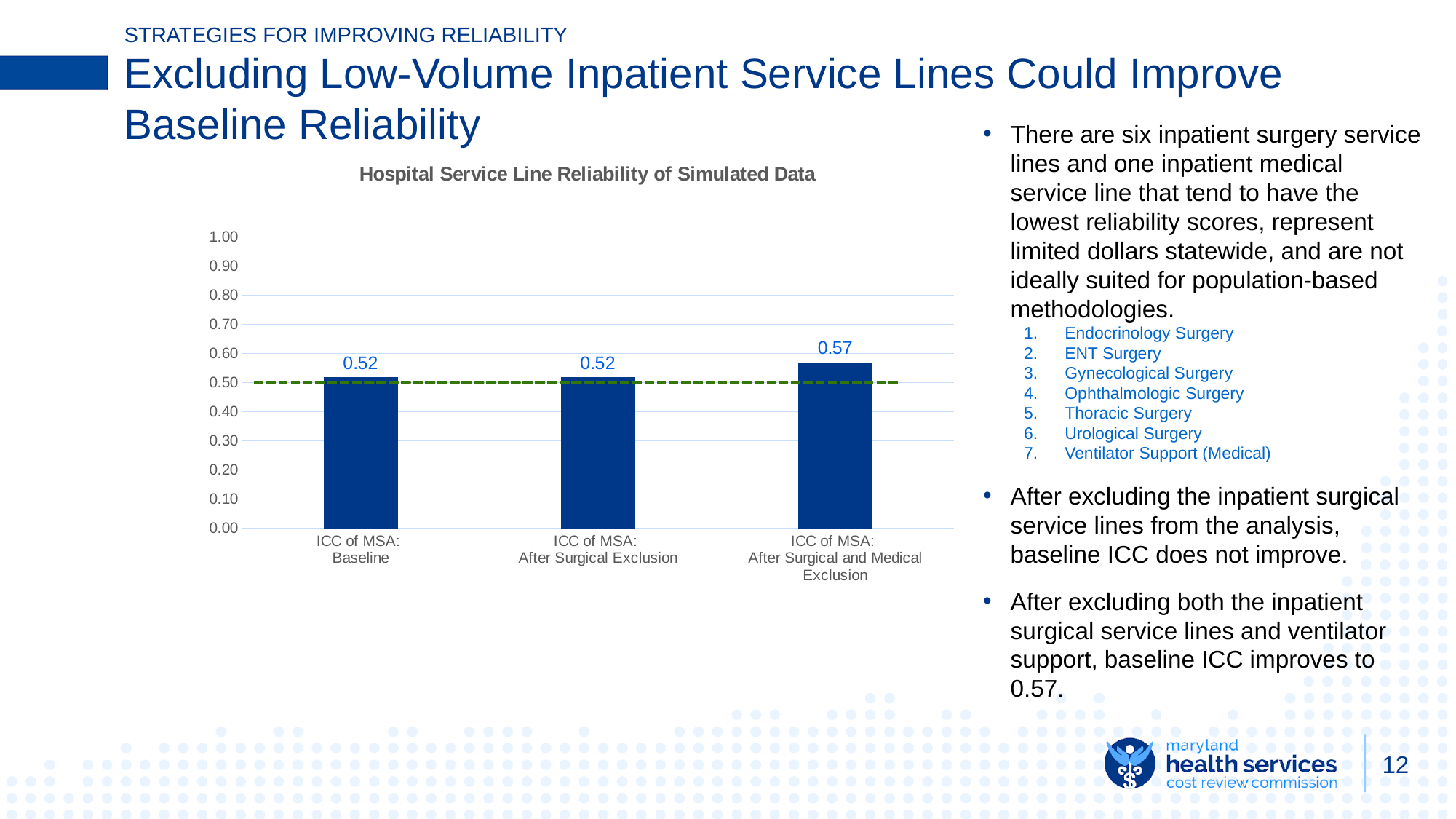
What is the value for ICC of MSA: After Surgical Exclusion? 0.52 What is the value for ICC of MSA: After Surgical and Medical Exclusion? 0.57 Do the values rise or fall from the first bar to the last bar? Rise What kind of chart is shown on the slide? Bar chart What is the title of the chart? Hospital Service Line Reliability of Simulated Data Is the value for ICC of MSA: Baseline greater or less than 0.50? greater What is the difference between the value for ICC of MSA: After Surgical and Medical Exclusion and the value for ICC of MSA: Baseline? 0.05 Is the value for ICC of MSA: After Surgical and Medical Exclusion greater or less than 0.60? less Which is larger, the value for ICC of MSA: After Surgical Exclusion or the value for ICC of MSA: After Surgical and Medical Exclusion? ICC of MSA: After Surgical and Medical Exclusion What is the value for ICC of MSA: Baseline? 0.52 How many bars are shown in the chart? 3 Which category has the highest value? ICC of MSA: After Surgical and Medical Exclusion